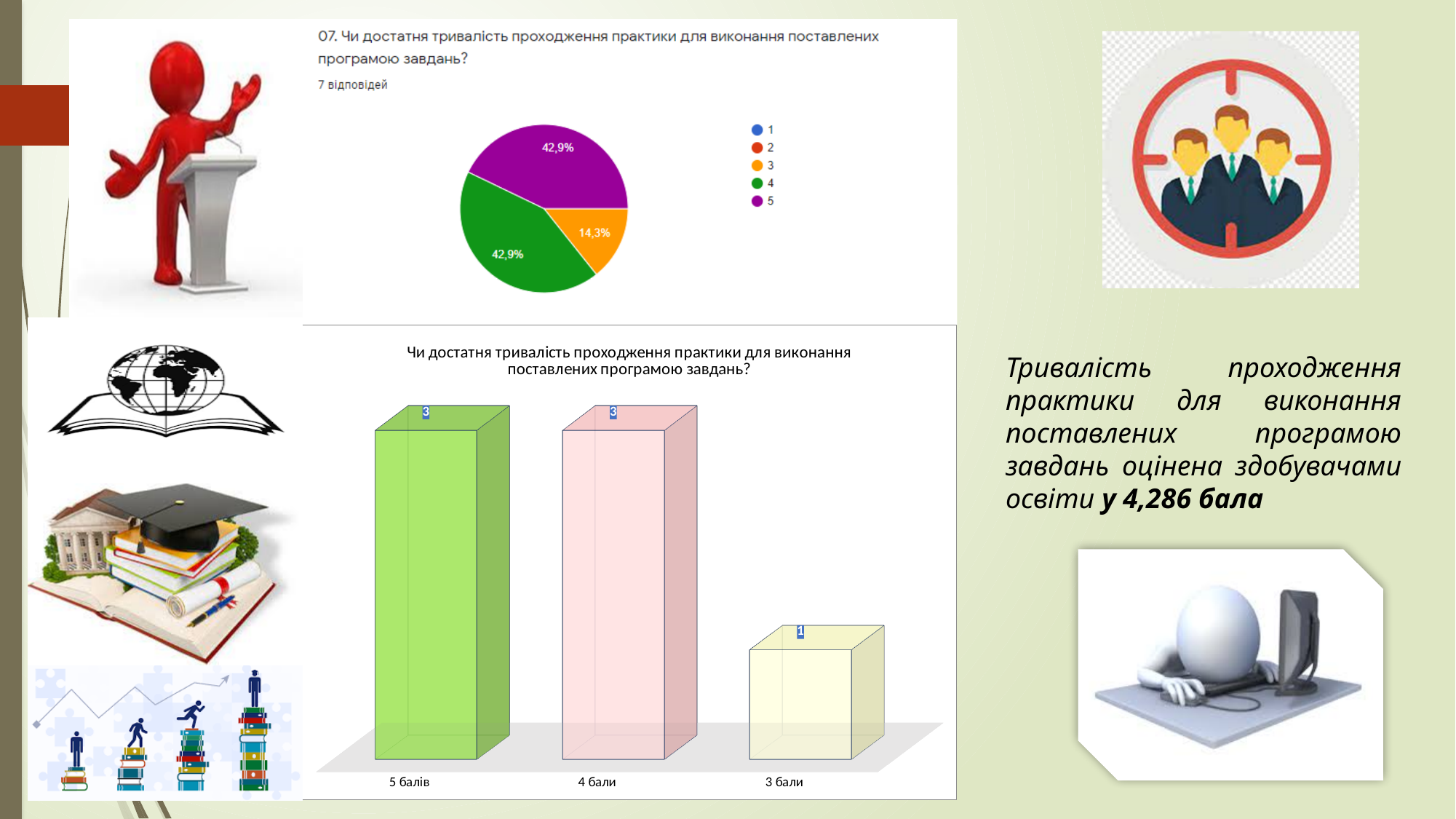
In the bottom bar chart, what is the difference between the values for "4 бали" and "3 бали"? 2 In the top pie chart, what share does the purple slice (5) have? 42,9% In the top pie chart, what share does the orange slice (3) have? 14,3% In the bottom bar chart, what is the total of all three bar values? 7 How many entries does the legend of the top pie chart list? 5 In the bottom bar chart, what is the value for "5 балів"? 3 How many categories are shown in the bottom bar chart? 3 In the bottom bar chart, which category has the lowest value? 3 бали What kind of chart is the bottom chart on the slide? bar chart In the bottom bar chart, which is larger: the value for "5 балів" or the value for "3 бали"? 5 балів What kind of chart is the top chart on the slide? pie chart In the bottom bar chart, what is the value for "3 бали"? 1